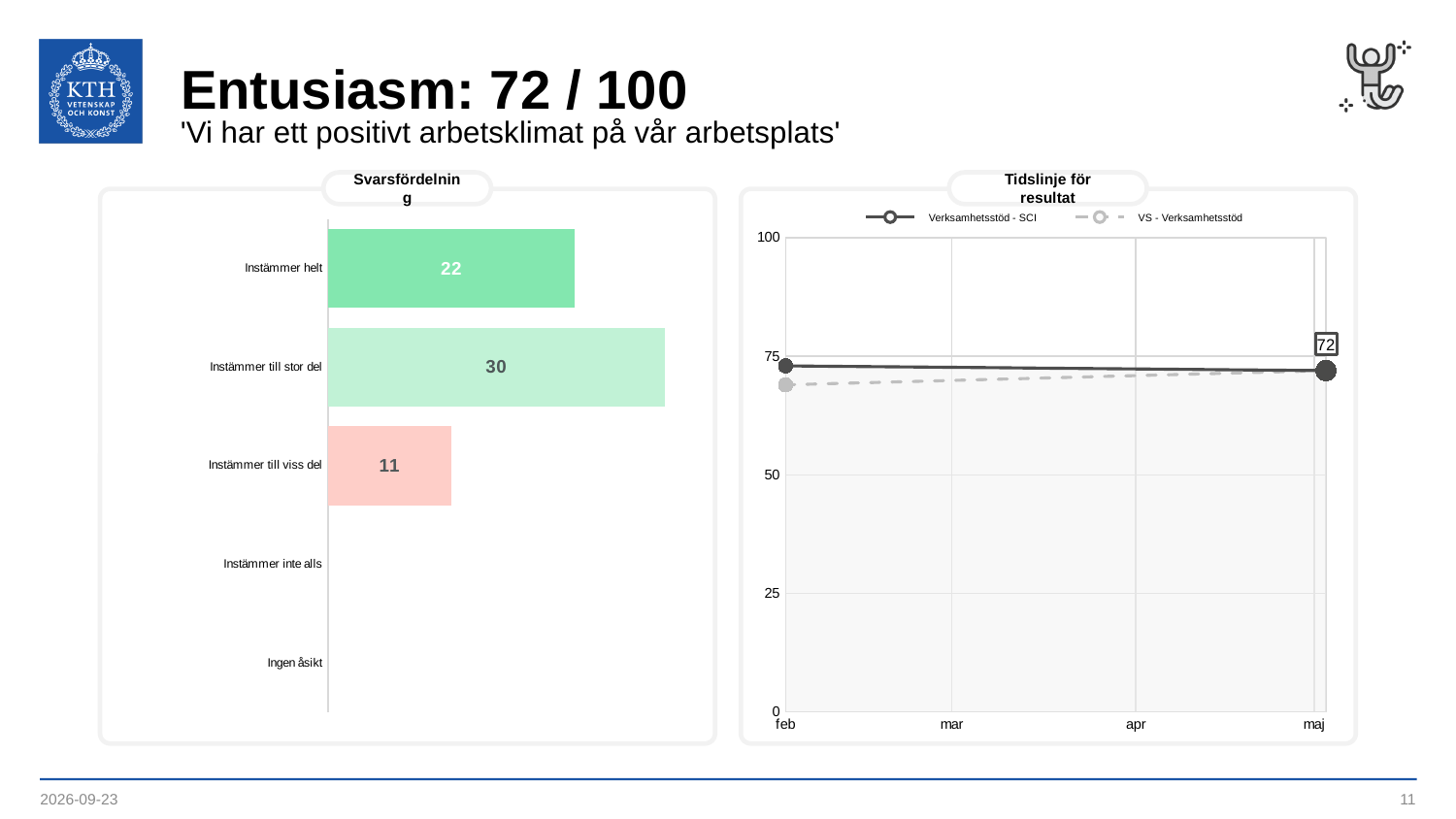
In the Svarsfördelning chart, what is the difference between Instämmer till stor del and Instämmer helt? 8 In the Tidslinje för resultat chart, what is the value of Verksamhetsstöd - SCI in maj? 72 In the Svarsfördelning chart, what is the value for Instämmer till viss del? 11 In the Svarsfördelning chart, how many categories are listed on the axis? 5 In the Tidslinje för resultat chart, is the value for VS - Verksamhetsstöd in feb greater or less than 75? less In the Svarsfördelning chart, which category has the highest value? Instämmer till stor del In the Svarsfördelning chart, what is the value for Instämmer helt? 22 In the Svarsfördelning chart, what is the value for Instämmer till stor del? 30 In the Tidslinje för resultat chart, how many months are shown on the x axis? 4 What kind of chart is the Svarsfördelning chart? Bar chart In the Tidslinje för resultat chart, how many series does the legend list? 2 In the Svarsfördelning chart, which is larger, Instämmer helt or Instämmer till viss del? Instämmer helt